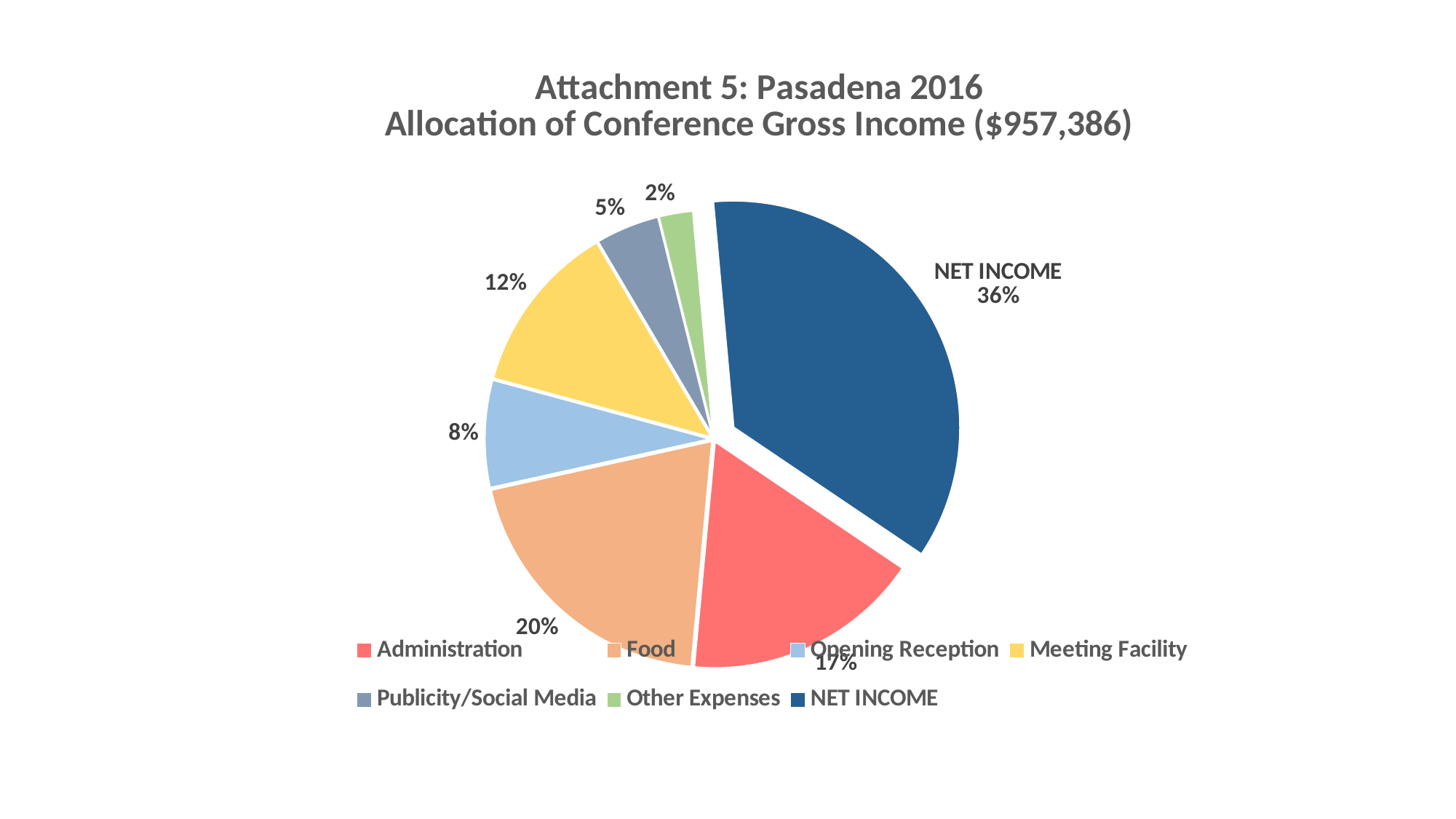
What kind of chart is shown on the slide? pie chart What share of the conference gross income goes to Opening Reception? 8% How many categories does the legend list? 7 What share of the conference gross income is NET INCOME? 36% What share of the conference gross income goes to Food? 20% What is the difference in percentage points between the Food share and the Administration share? 3 Which is larger, the Meeting Facility share or the Opening Reception share? Meeting Facility Which category has the largest slice of the pie? NET INCOME Which category has the smallest slice of the pie? Other Expenses